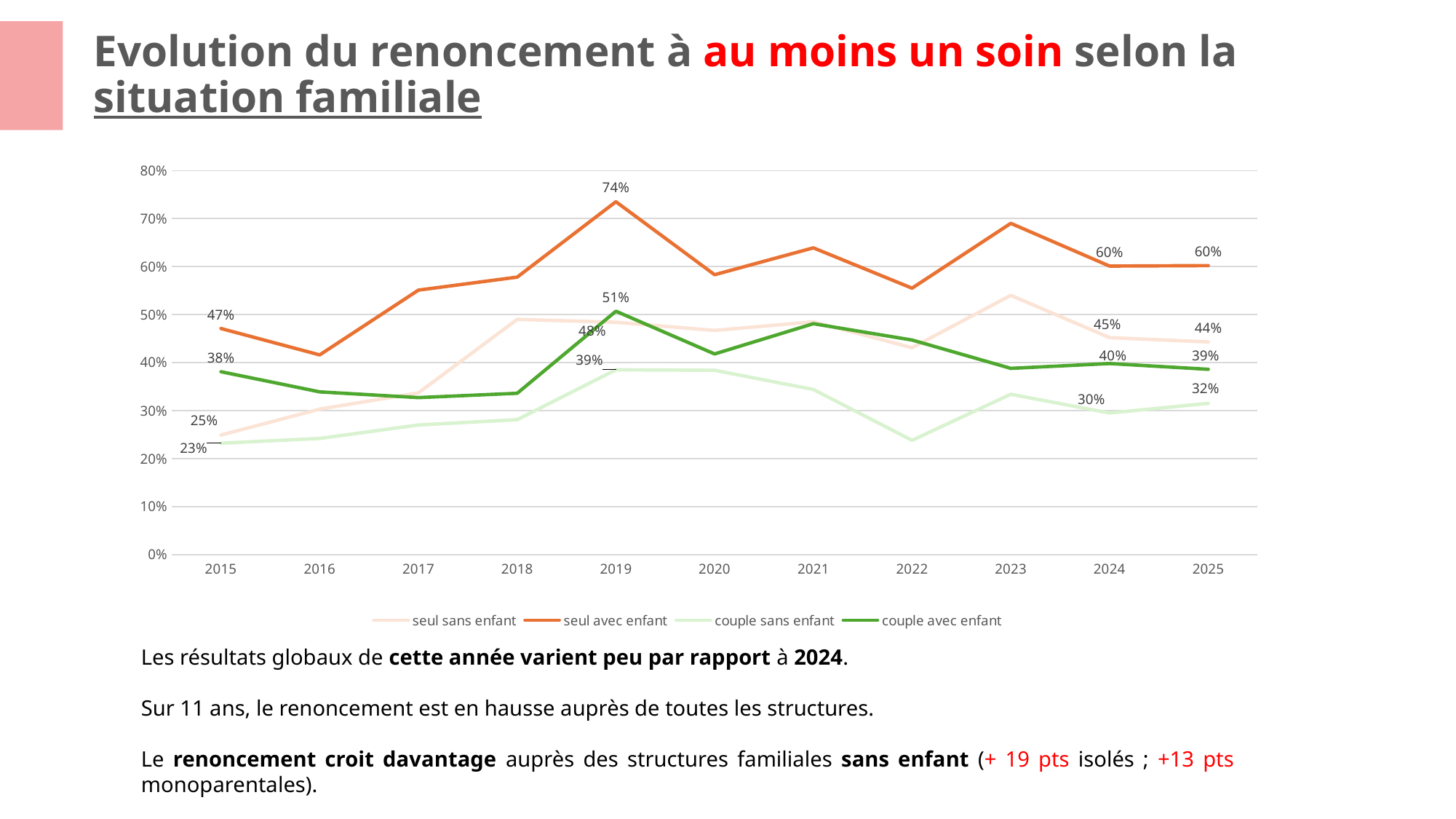
By how many percentage points did 'seul avec enfant' change between 2015 and 2019? 27 points What is the value for 'seul sans enfant' in 2024? 45% What is the value for 'couple sans enfant' in 2015? 23% How many series does the legend list? 4 What is the value for 'couple avec enfant' in 2025? 39% Is the value for 'seul avec enfant' in 2023 greater or less than 60%? greater Which series has the highest value in 2019? seul avec enfant How many years are shown on the x axis? 11 What is the value for 'seul avec enfant' in 2019? 74% By how many percentage points did 'seul sans enfant' change between 2015 and 2025? 19 points In 2025, which is larger: 'seul sans enfant' or 'couple avec enfant'? seul sans enfant Which series has the lowest value in 2025? couple sans enfant